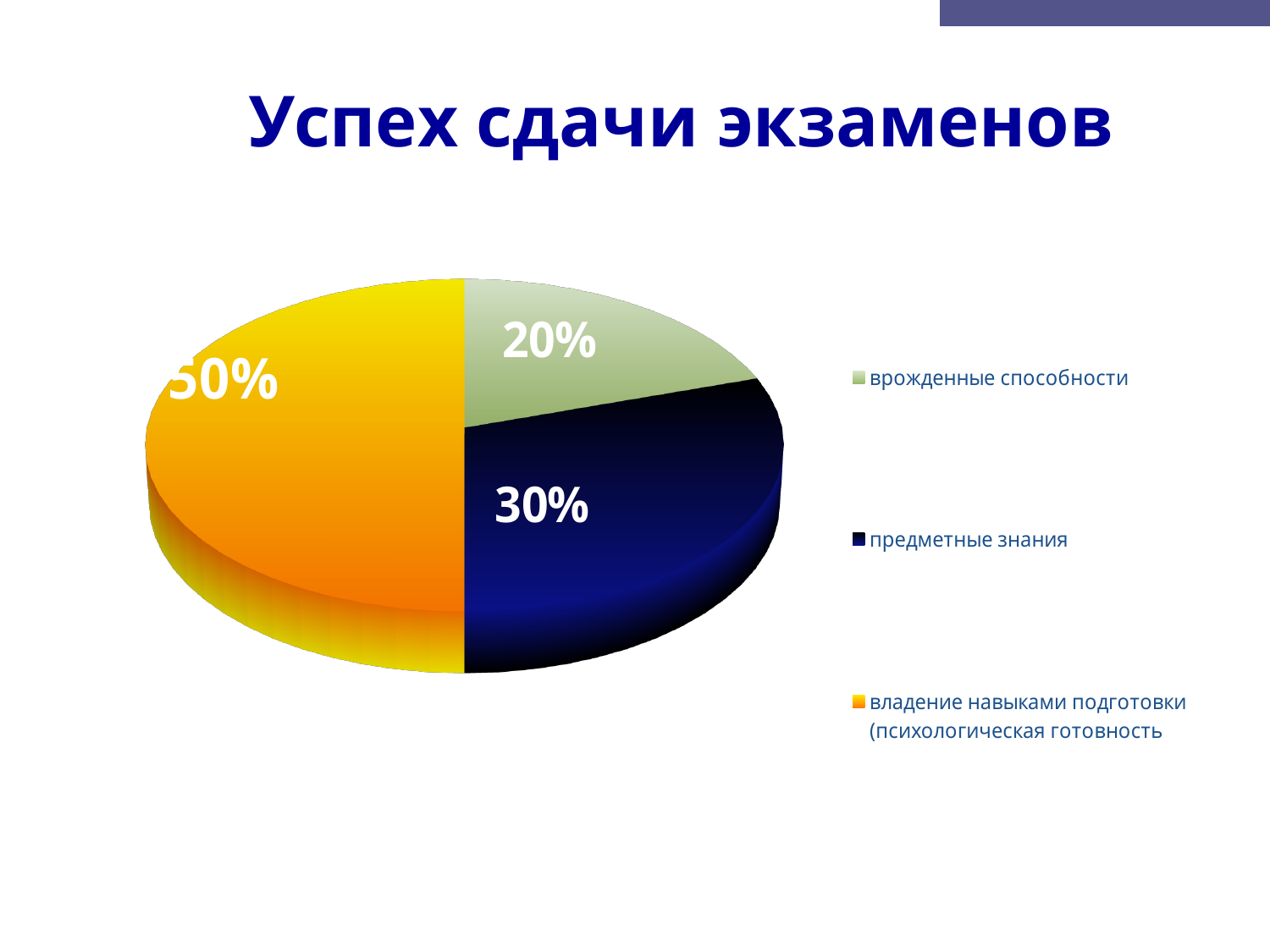
What is the value for врожденные способности? 20% What is the value for предметные знания? 30% What is the difference between the values for предметные знания and врожденные способности? 10% Which is larger, the slice for предметные знания or the slice for врожденные способности? предметные знания How many slices does the pie chart have? 3 What colour is the slice for предметные знания? dark blue What is the value for владение навыками подготовки (психологическая готовность)? 50% What is the title of the slide containing the chart? Успех сдачи экзаменов Which category has the smallest slice of the pie? врожденные способности What is the difference between the values for владение навыками подготовки and предметные знания? 20% Which category has the largest slice of the pie? владение навыками подготовки (психологическая готовность) What kind of chart is shown on the slide? pie chart